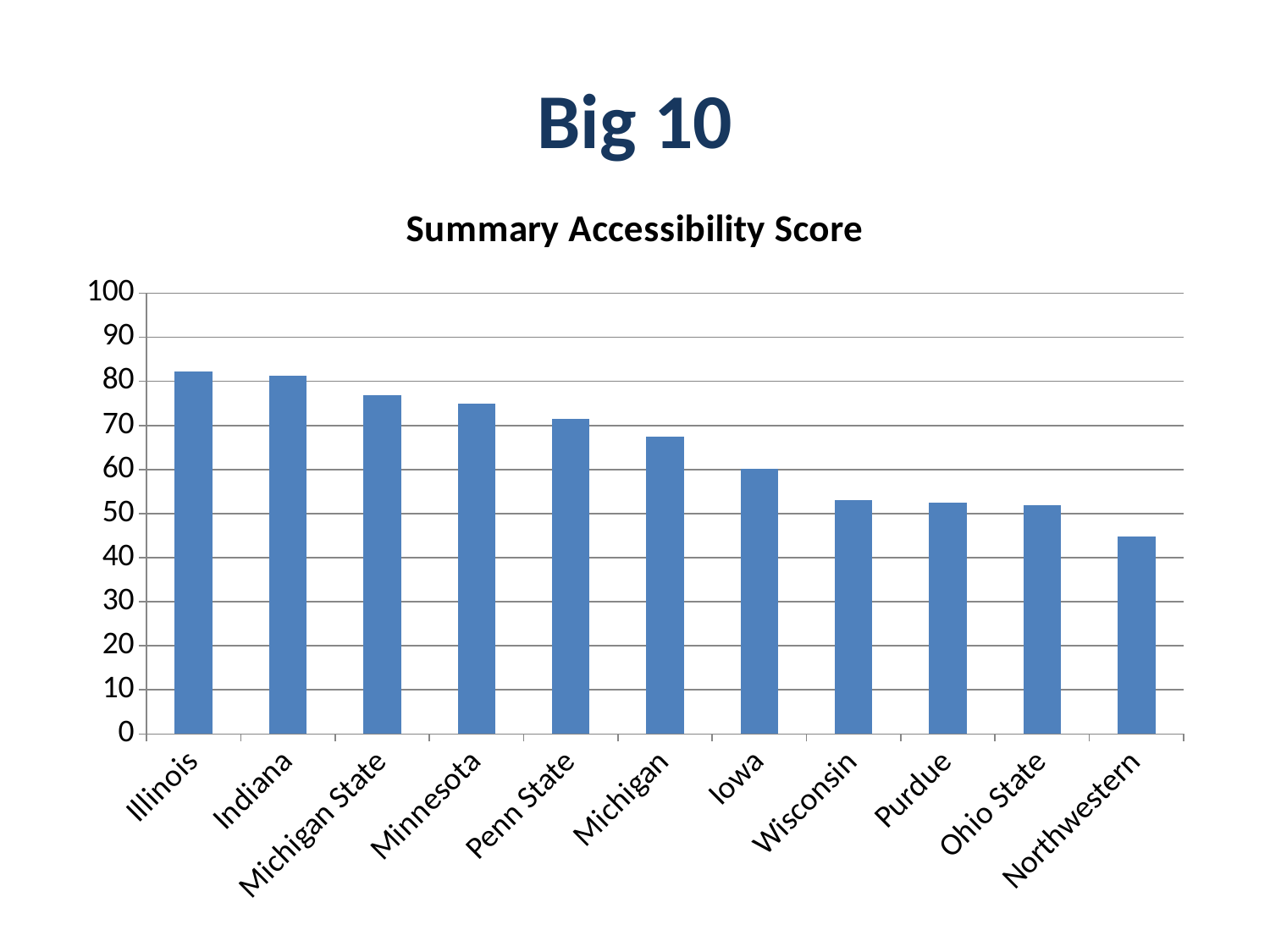
Which university has the lowest Summary Accessibility Score? Northwestern Is the value for Michigan State greater or less than 70? greater Is the value for Michigan greater or less than 60? greater Is the value for Wisconsin greater or less than 60? less What kind of chart is shown on the slide? bar chart How many universities are shown on the x axis of the chart? 11 Which has a higher Summary Accessibility Score, Michigan State or Michigan? Michigan State What is the title of the chart? Summary Accessibility Score Do the values rise or fall moving from left to right along the x axis? fall Which has a higher Summary Accessibility Score, Iowa or Minnesota? Minnesota